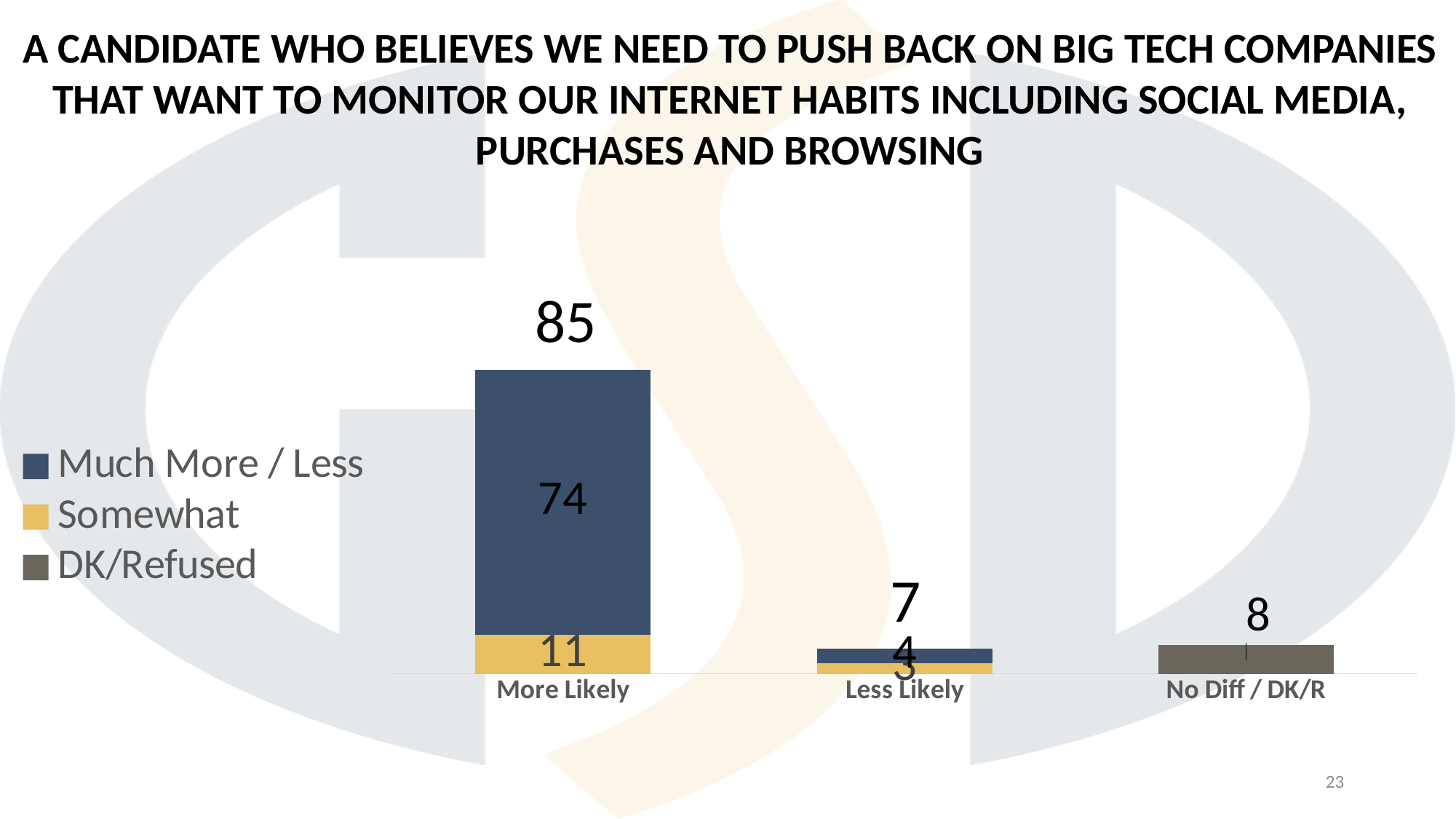
Which is larger, the Much More / Less value for More Likely or for Less Likely? More Likely What kind of chart is shown on the slide? Bar chart What is the total of the stacked bar for More Likely? 85 What is the Much More / Less value for More Likely? 74 What is the value for No Diff / DK/R? 8 What is the Somewhat value for More Likely? 11 How many series does the legend list? 3 Which category has the highest total? More Likely How many categories are shown on the x axis of the chart? 3 What is the difference between the total for More Likely and the total for Less Likely? 78 Which category has the lowest total? Less Likely What is the total of the stacked bar for Less Likely? 7